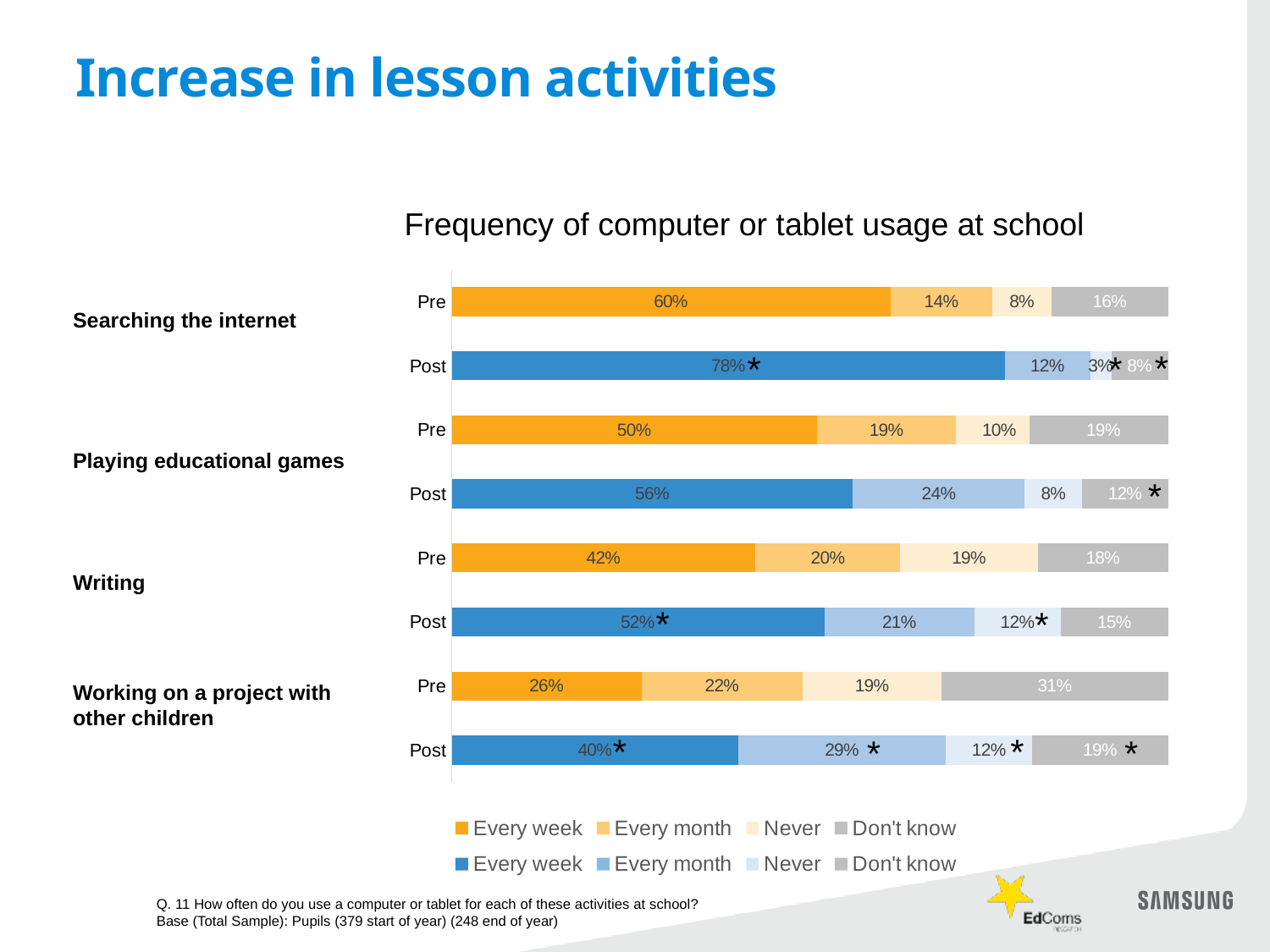
What type of chart is shown on the slide? Stacked bar chart Is the Pre 'Every week' value for Writing larger or smaller than the Post 'Every week' value for Writing? smaller What is the 'Don't know' value for Working on a project with other children in the Pre bar? 31% What is the 'Every month' value for Playing educational games in the Post bar? 24% What is the 'Every week' value for Searching the internet in the Post bar? 78% How many entries does the legend list? 8 What is the 'Never' value for Writing in the Pre bar? 19% By how many percentage points did the 'Every week' value for Searching the internet change from Pre to Post? 18 percentage points Which activity has the highest 'Every week' value in the Post bars? Searching the internet What is the difference between the Pre and Post 'Every week' values for Working on a project with other children? 14 percentage points Which activity has the lowest 'Every week' value in the Pre bars? Working on a project with other children How many activities are shown on the chart? 4